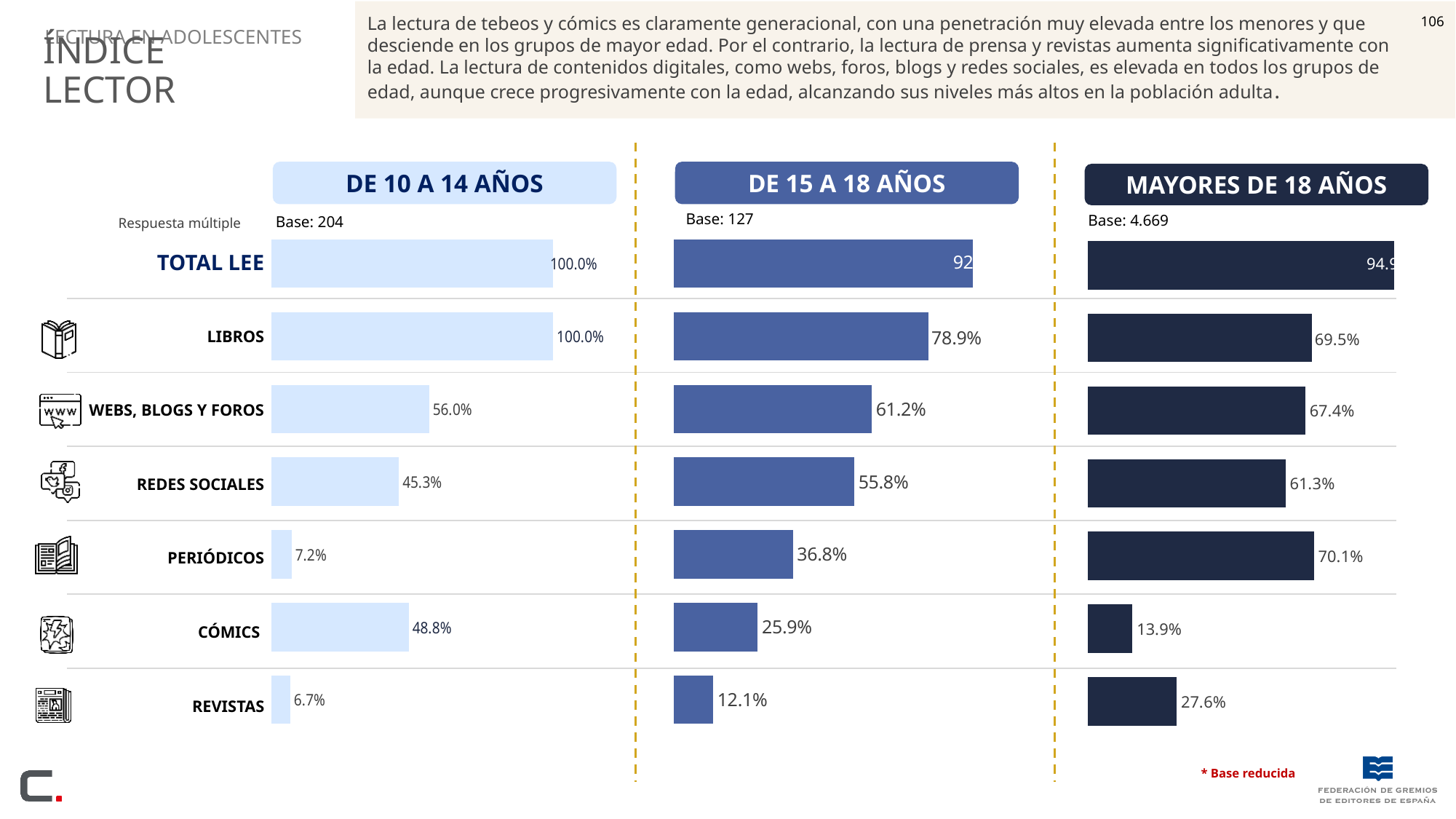
In the 'DE 10 A 14 AÑOS' chart, what is the value for CÓMICS? 48.8% In the 'DE 15 A 18 AÑOS' chart, which is larger: WEBS, BLOGS Y FOROS or REDES SOCIALES? WEBS, BLOGS Y FOROS In the 'MAYORES DE 18 AÑOS' chart, which category (excluding TOTAL LEE) has the lowest value? CÓMICS In the 'DE 10 A 14 AÑOS' chart, which category (excluding TOTAL LEE) has the lowest value? REVISTAS What is the base (sample size) shown for the 'DE 15 A 18 AÑOS' chart? 127 In the 'MAYORES DE 18 AÑOS' chart, which category (excluding TOTAL LEE) has the highest value? PERIÓDICOS In the 'MAYORES DE 18 AÑOS' chart, what is the value for REVISTAS? 27.6% In the 'DE 15 A 18 AÑOS' chart, what is the value for PERIÓDICOS? 36.8% What is the difference between the CÓMICS value in the 'DE 10 A 14 AÑOS' chart and the CÓMICS value in the 'MAYORES DE 18 AÑOS' chart? 34.9% What type of chart is used on this slide? Bar chart In the 'DE 15 A 18 AÑOS' chart, what is the value for LIBROS? 78.9% What is the difference between the PERIÓDICOS value in the 'MAYORES DE 18 AÑOS' chart and the PERIÓDICOS value in the 'DE 10 A 14 AÑOS' chart? 62.9%